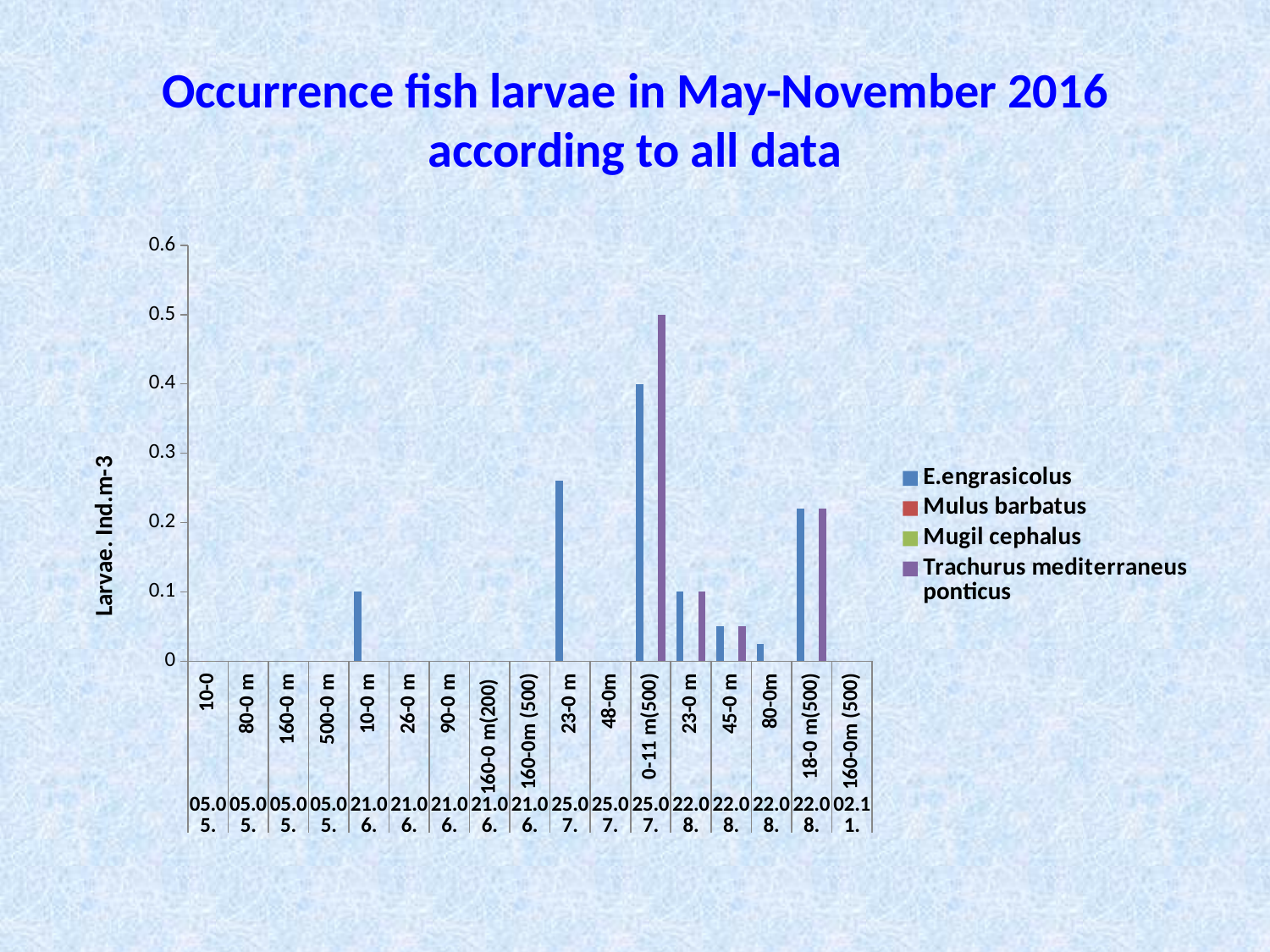
What is the label of the y axis? Larvae. Ind.m-3 What kind of chart is shown on the slide? bar chart What is the value for Trachurus mediterraneus ponticus at 0-11 m(500) (25.07.)? 0.5 Is the value for E.engrasicolus at 45-0 m (22.08.) greater or less than 0.1? less At 0-11 m(500) (25.07.), which is larger: E.engrasicolus or Trachurus mediterraneus ponticus? Trachurus mediterraneus ponticus Is the value for Trachurus mediterraneus ponticus at 18-0 m(500) (22.08.) greater or less than 0.2? greater Which series has the highest bar on the chart? Trachurus mediterraneus ponticus What is the value for E.engrasicolus at 0-11 m(500) (25.07.)? 0.4 How many series does the legend list? 4 Is the value for E.engrasicolus at 23-0 m (25.07.) greater or less than 0.2? greater What is the value for E.engrasicolus at 10-0 m (21.06.)? 0.1 How many categories are shown along the x axis? 17